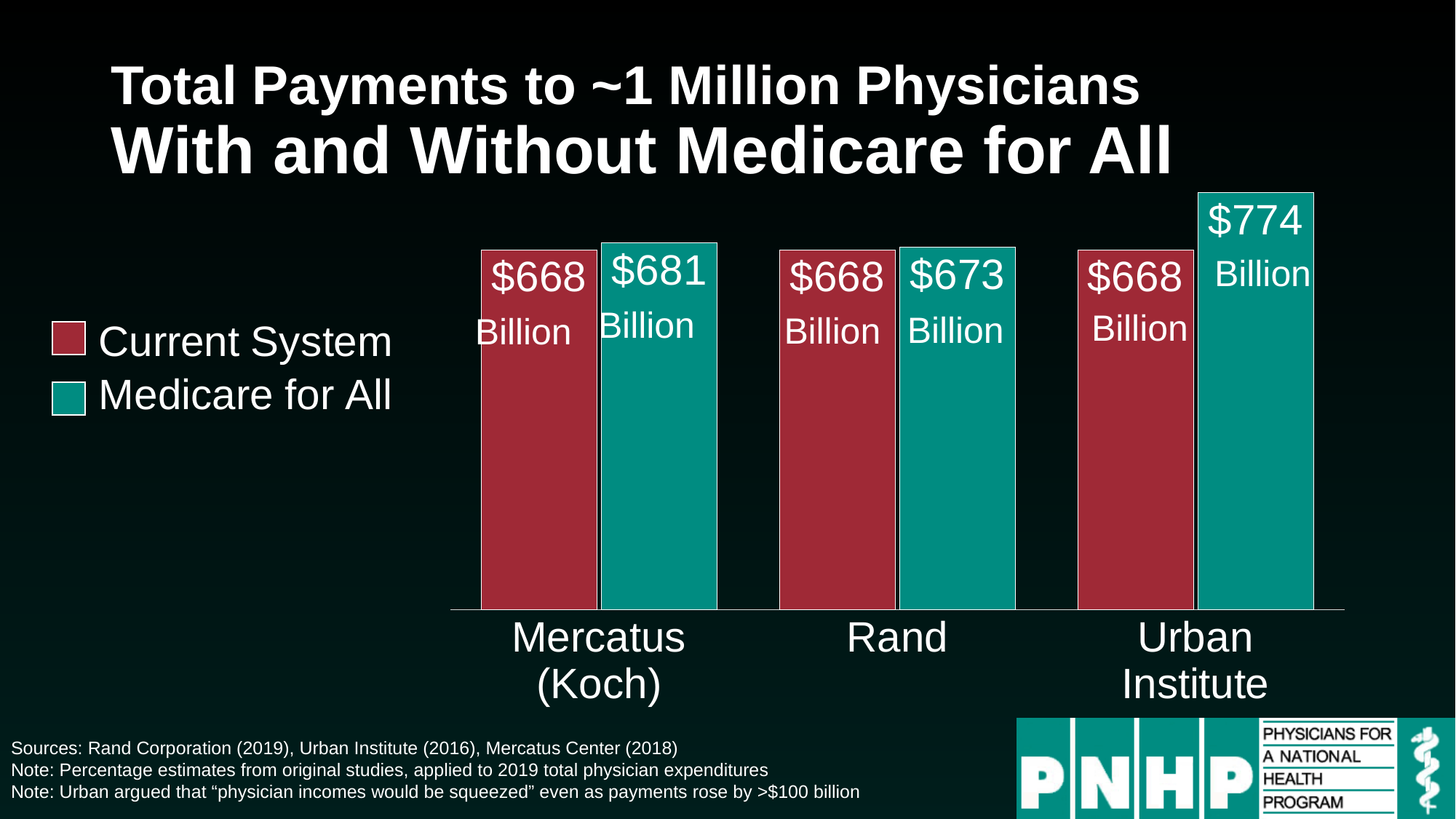
What is the Current System value for Rand? $668 Billion Which is larger for Mercatus (Koch): the Current System value or the Medicare for All value? Medicare for All Which study shows the lowest Medicare for All payment? Rand What kind of chart is shown on the slide? Bar chart What is the Medicare for All value for Urban Institute? $774 Billion What is the difference between the Medicare for All and Current System values for Urban Institute? $106 Billion Which study shows the highest Medicare for All payment? Urban Institute What is the Medicare for All value for Mercatus (Koch)? $681 Billion How many studies are shown on the x axis? 3 How many series does the legend list? 2 What is the difference between the Medicare for All values for Mercatus (Koch) and Rand? $8 Billion What is the Medicare for All value for Rand? $673 Billion